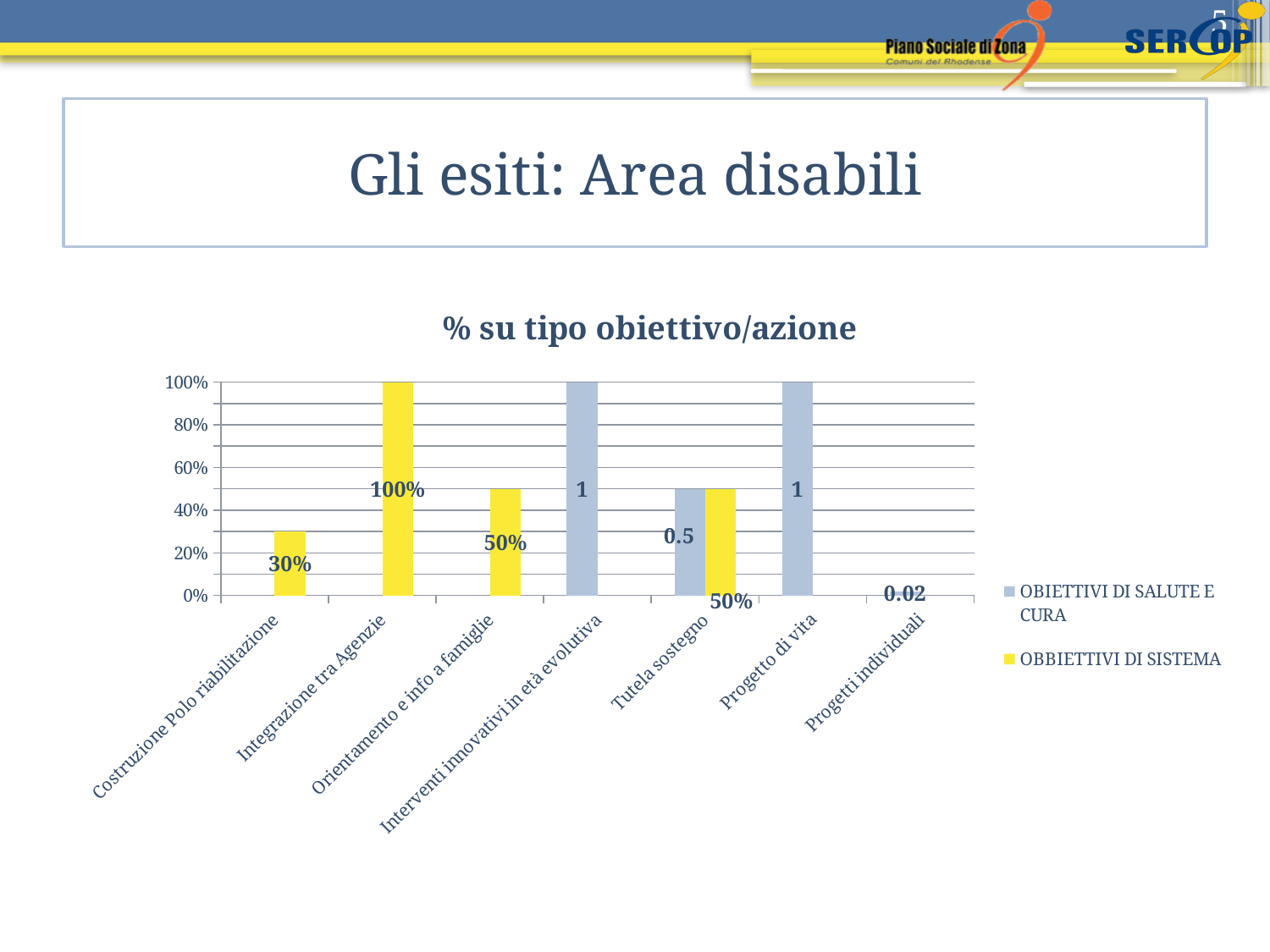
Which category has the lowest value for OBBIETTIVI DI SISTEMA? Costruzione Polo riabilitazione What is the value labelled for OBBIETTIVI DI SISTEMA at Integrazione tra Agenzie? 100% How many categories are shown on the x axis of the chart? 7 What is the value labelled for OBIETTIVI DI SALUTE E CURA at Progetti individuali? 0.02 What is the title of the chart? % su tipo obiettivo/azione What is the value labelled for OBBIETTIVI DI SISTEMA at Costruzione Polo riabilitazione? 30% What is the value labelled for OBIETTIVI DI SALUTE E CURA at Tutela sostegno? 0.5 How many series does the legend list? 2 Which is larger: the OBBIETTIVI DI SISTEMA value at Costruzione Polo riabilitazione or at Orientamento e info a famiglie? Orientamento e info a famiglie What is the difference between the OBBIETTIVI DI SISTEMA values at Integrazione tra Agenzie and Orientamento e info a famiglie? 50% What kind of chart is shown on the slide? bar chart Which category has the lowest value for OBIETTIVI DI SALUTE E CURA? Progetti individuali